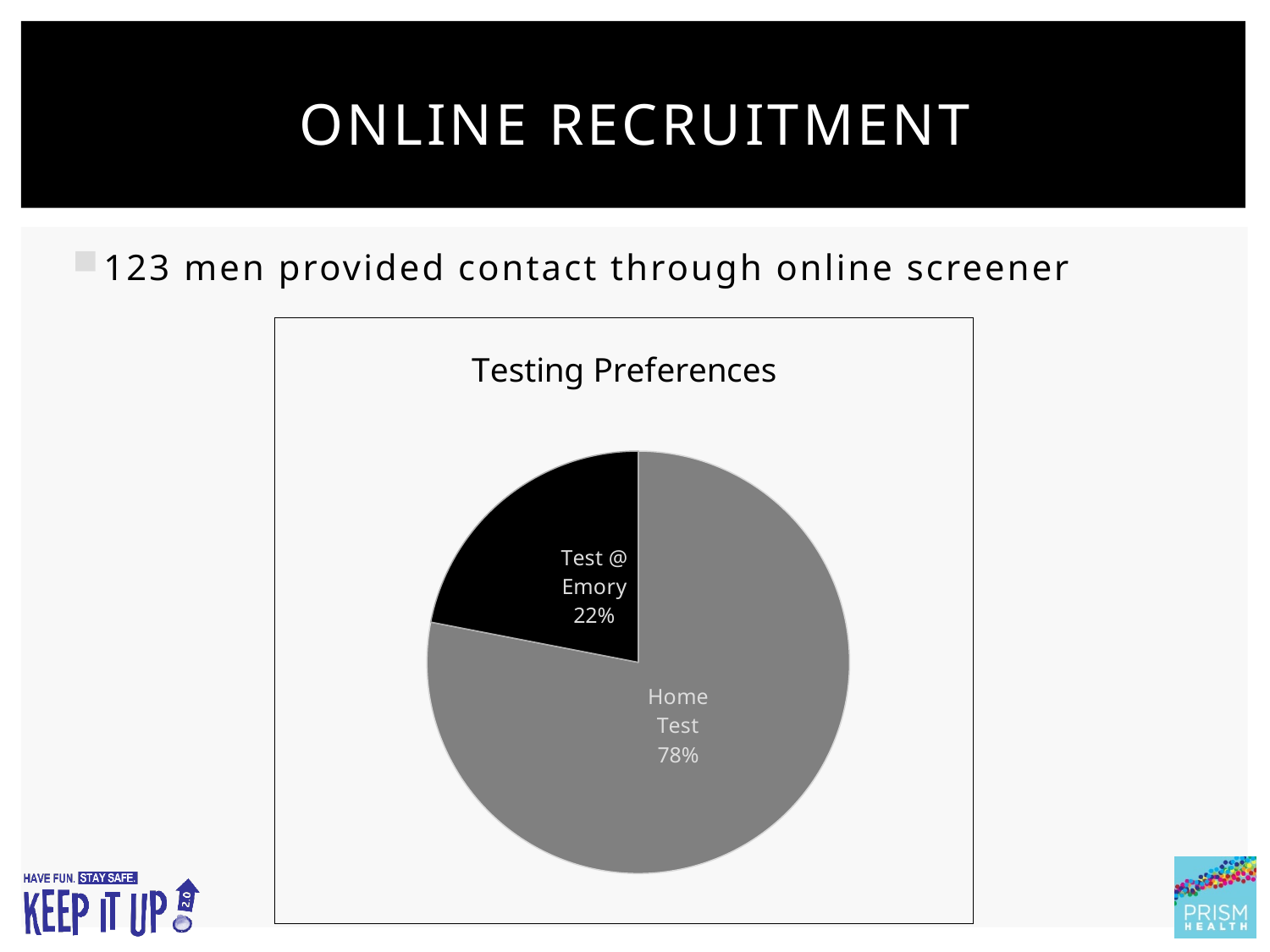
What colour is the Test @ Emory slice? black What is the difference in percentage points between Home Test and Test @ Emory? 56 Which is larger, the Home Test slice or the Test @ Emory slice? Home Test What type of chart is shown on the slide? pie chart Which slice of the pie is the largest? Home Test Which slice of the pie is the smallest? Test @ Emory What share of the pie is Test @ Emory? 22% What share of the pie is Home Test? 78% How many slices does the pie chart have? 2 What is the title of the chart? Testing Preferences